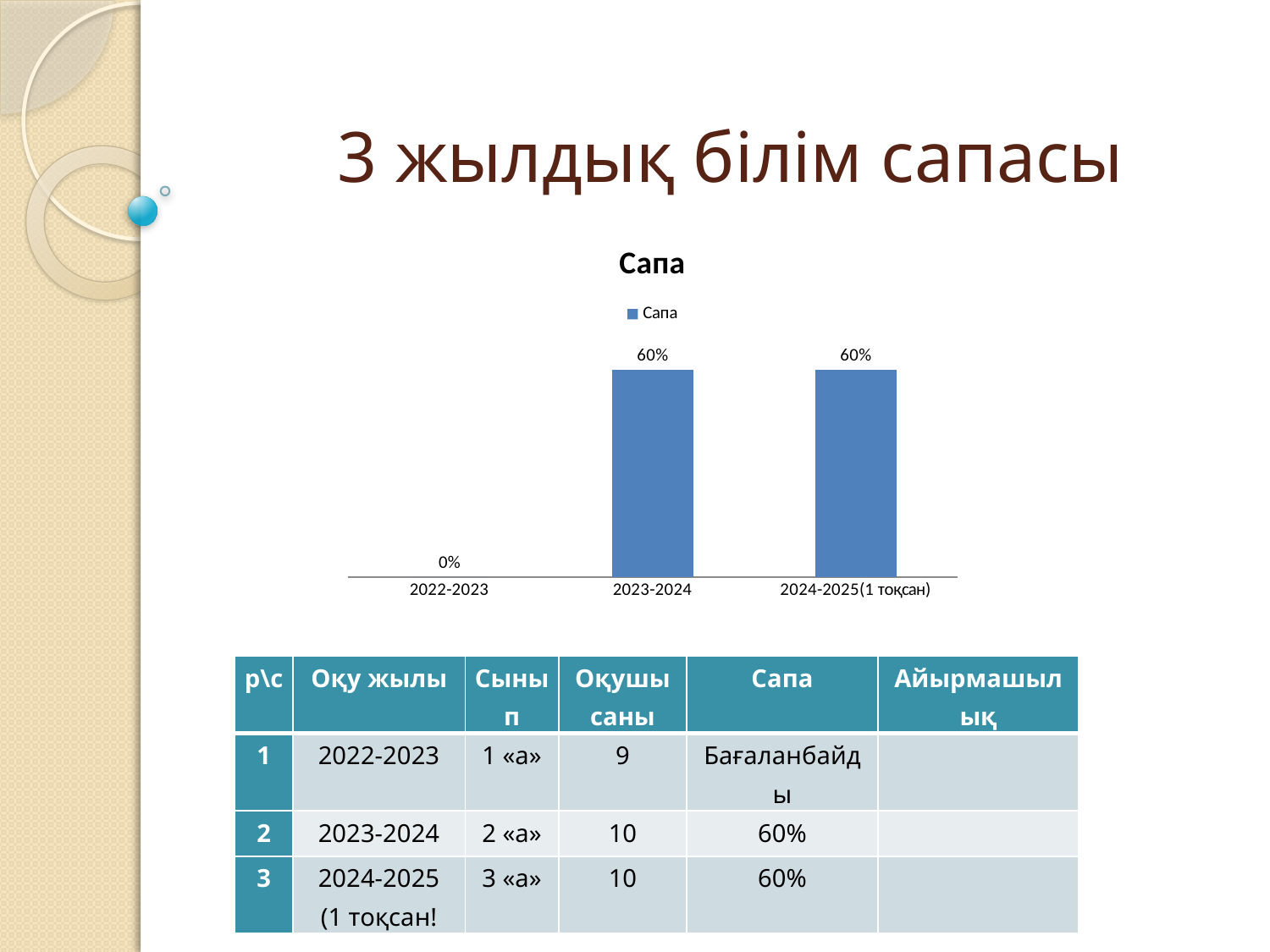
How many categories are shown on the x axis of the chart? 3 What is the title of the chart? Сапа What is the value for 2023-2024 in the chart? 60% Which category has the lowest value in the chart? 2022-2023 What is the value for 2022-2023 in the chart? 0% How many series does the chart legend list? 1 Does the value rise or fall from 2022-2023 to 2023-2024? Rise Are the values for 2023-2024 and 2024-2025(1 тоқсан) equal? Yes What kind of chart is shown on the slide? Bar chart Which is larger, the value for 2023-2024 or the value for 2022-2023? 2023-2024 What is the difference between the values for 2023-2024 and 2022-2023? 60% What is the value for 2024-2025(1 тоқсан) in the chart? 60%